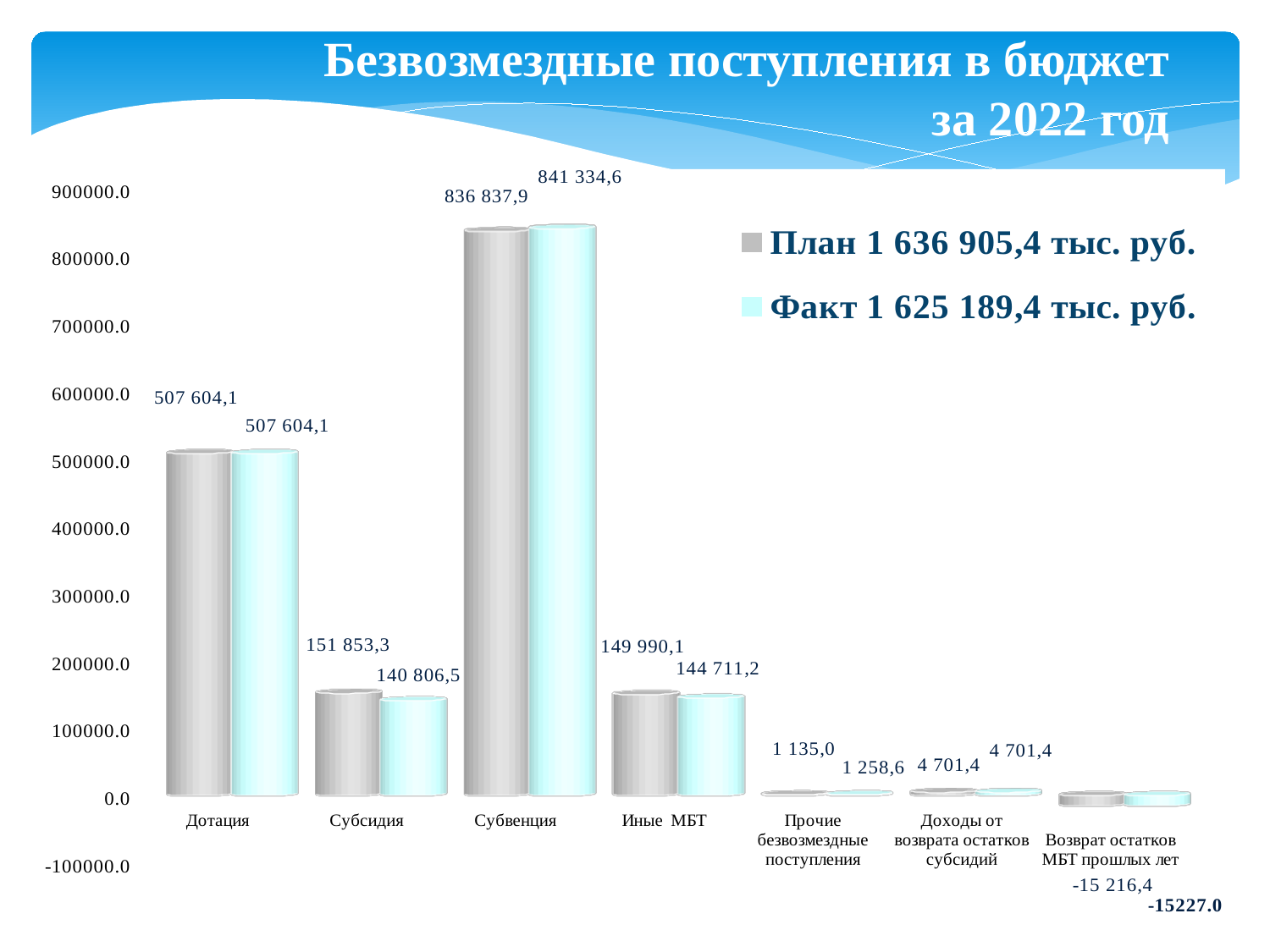
What is the Факт value for Иные МБТ? 144 711,2 What kind of chart is shown on the slide? Bar chart What is the План value for Субвенция? 836 837,9 How many series does the legend list? 2 For Иные МБТ, which is larger: the План value or the Факт value? План What is the План value for Дотация? 507 604,1 What is the difference between the Факт and План values for Субвенция? 4 496,7 What is the difference between the План and Факт values for Субсидия? 11 046,8 Which category has the lowest values in the chart? Возврат остатков МБТ прошлых лет What is the Факт value for Субсидия? 140 806,5 How many categories are shown on the x axis? 7 Which category has the highest План value? Субвенция